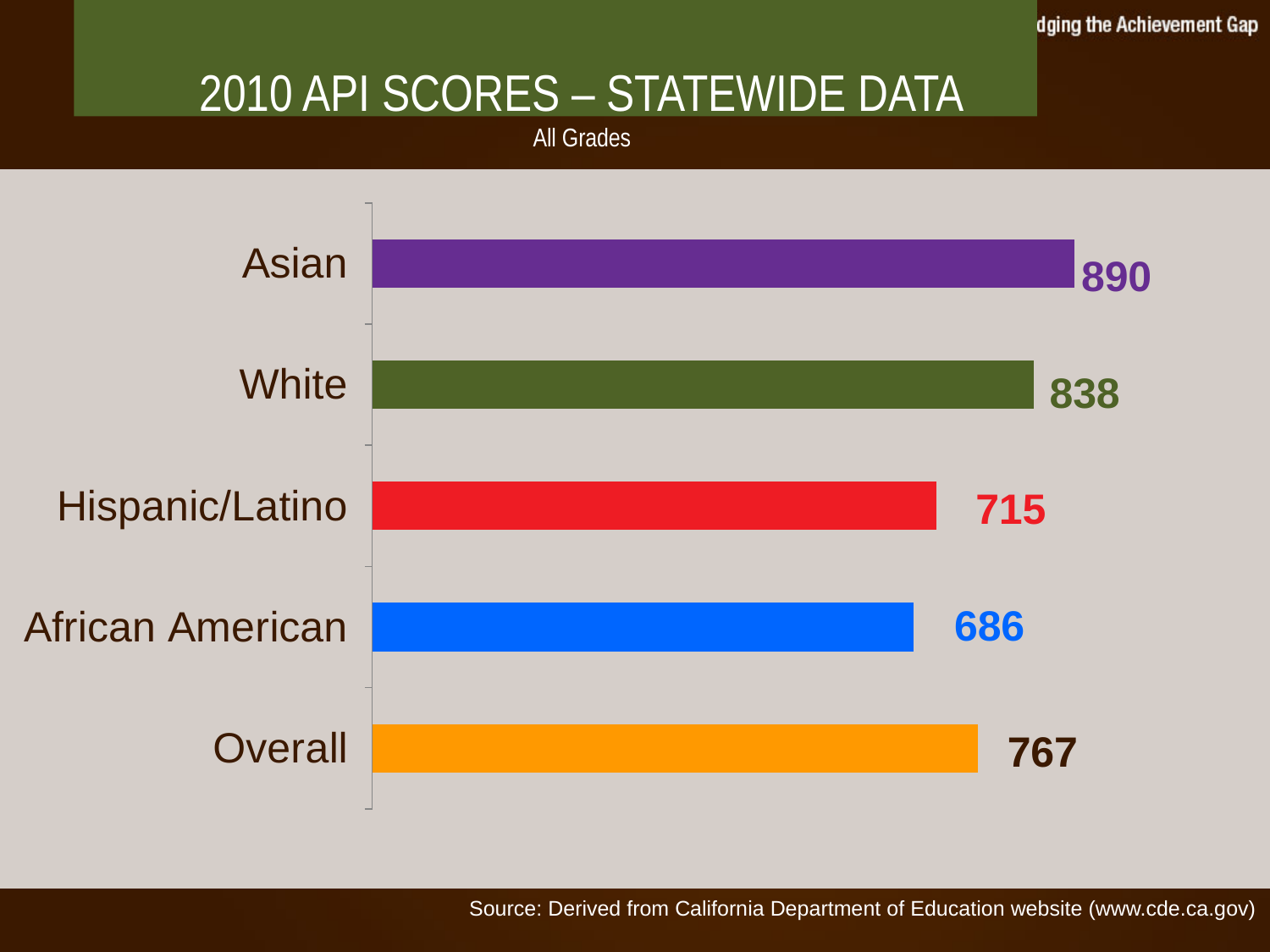
What is the 2010 API score for Asian students? 890 How many categories are shown on the chart? 5 What is the difference between the Overall API score and the African American API score? 81 Which group has the highest API score on the chart? Asian What is the difference between the API scores for Asian and White students? 52 What is the 2010 API score for Hispanic/Latino students? 715 Which has a higher API score, White or Overall? White What kind of chart is shown on the slide? Bar chart Which has a higher API score, Hispanic/Latino or African American? Hispanic/Latino What colour is the bar for African American? Blue What is the Overall 2010 API score shown on the chart? 767 Which group has the lowest API score on the chart? African American